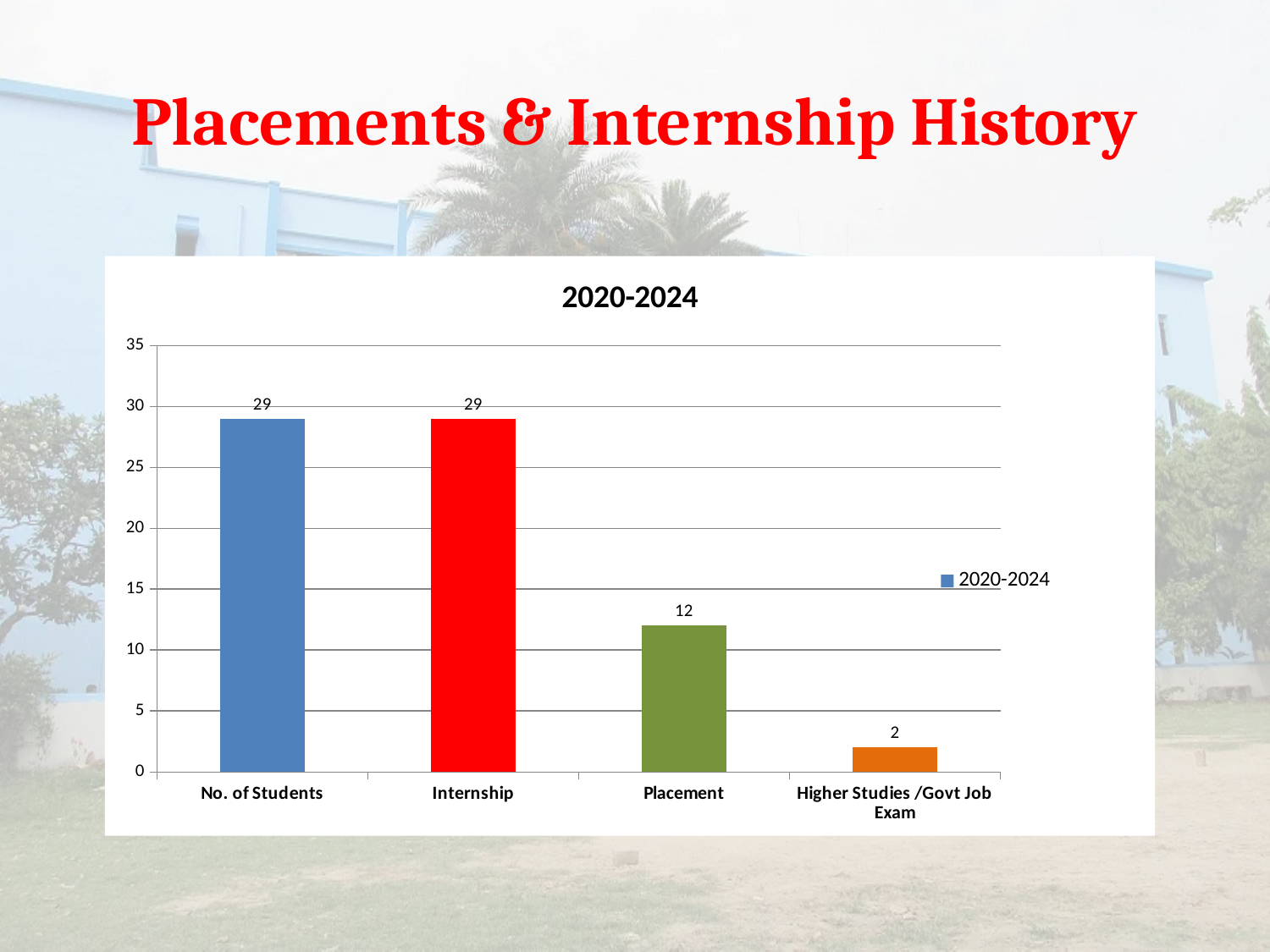
What is the difference between the values for Placement and Higher Studies /Govt Job Exam? 10 Which category has the lowest value? Higher Studies /Govt Job Exam What is the value for Internship? 29 What is the value for Placement? 12 What is the value for Higher Studies /Govt Job Exam? 2 What is the difference between the values for Internship and Placement? 17 How many series does the legend list? 1 What is the title of the chart? 2020-2024 What is the value for No. of Students? 29 Which is larger, the value for Placement or the value for Higher Studies /Govt Job Exam? Placement How many categories are shown on the x axis? 4 What kind of chart is shown on the slide? Bar chart